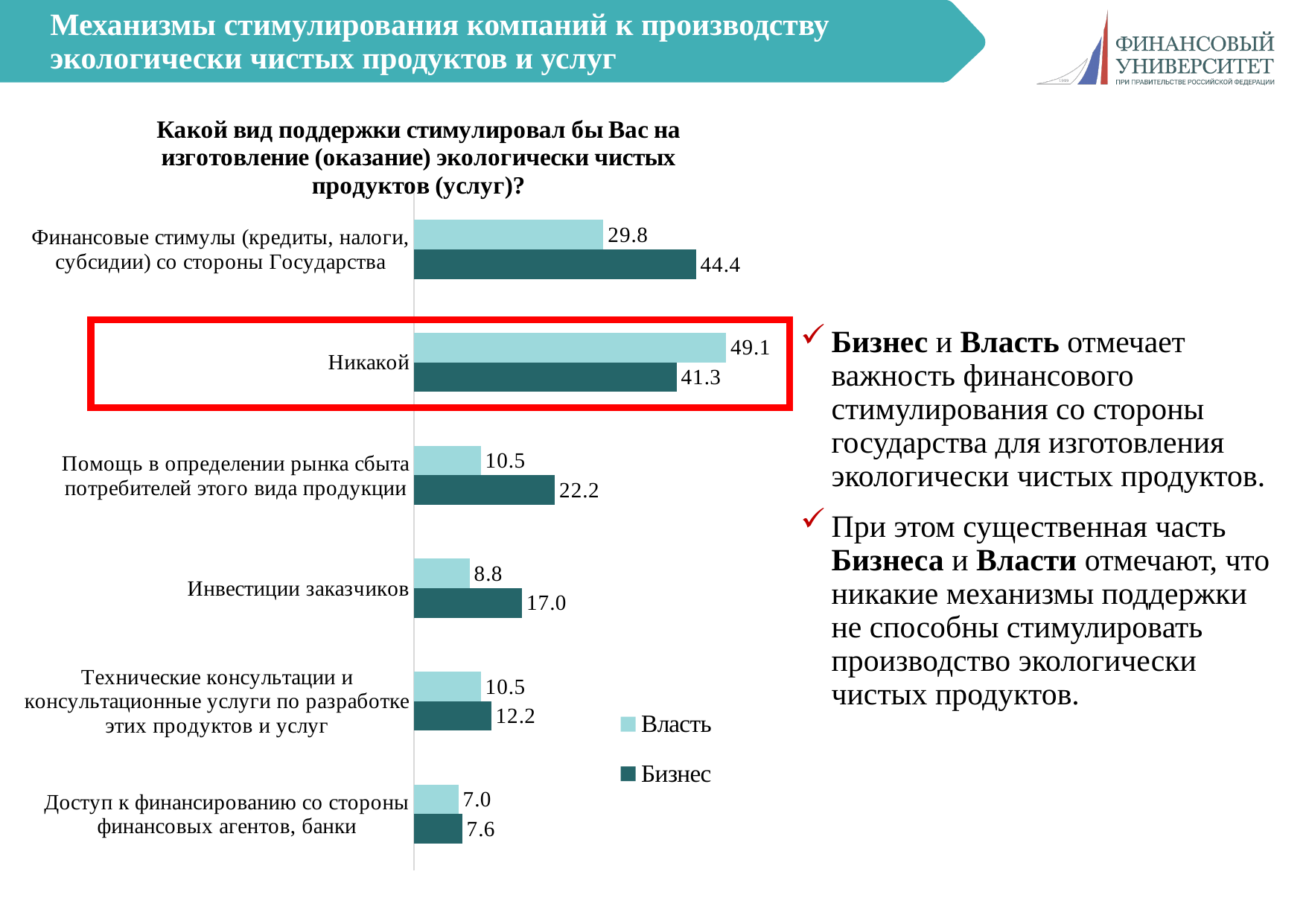
Which category has the highest value for the Власть series? Никакой What type of chart is shown on the slide? Bar chart How many series does the chart legend list? 2 What is the difference between the Бизнес and Власть values for "Финансовые стимулы (кредиты, налоги, субсидии) со стороны Государства"? 14.6 What is the difference between the Власть and Бизнес values for "Никакой"? 7.8 What is the value for Бизнес in the category "Инвестиции заказчиков"? 17.0 What is the value for Бизнес in the category "Финансовые стимулы (кредиты, налоги, субсидии) со стороны Государства"? 44.4 How many categories are shown in the chart? 6 Which series is shown in the darker colour in the chart? Бизнес Which is larger for "Помощь в определении рынка сбыта потребителей этого вида продукции": the Власть value or the Бизнес value? Бизнес Which category has the lowest value for the Бизнес series? Доступ к финансированию со стороны финансовых агентов, банки What is the value for Власть in the category "Никакой"? 49.1